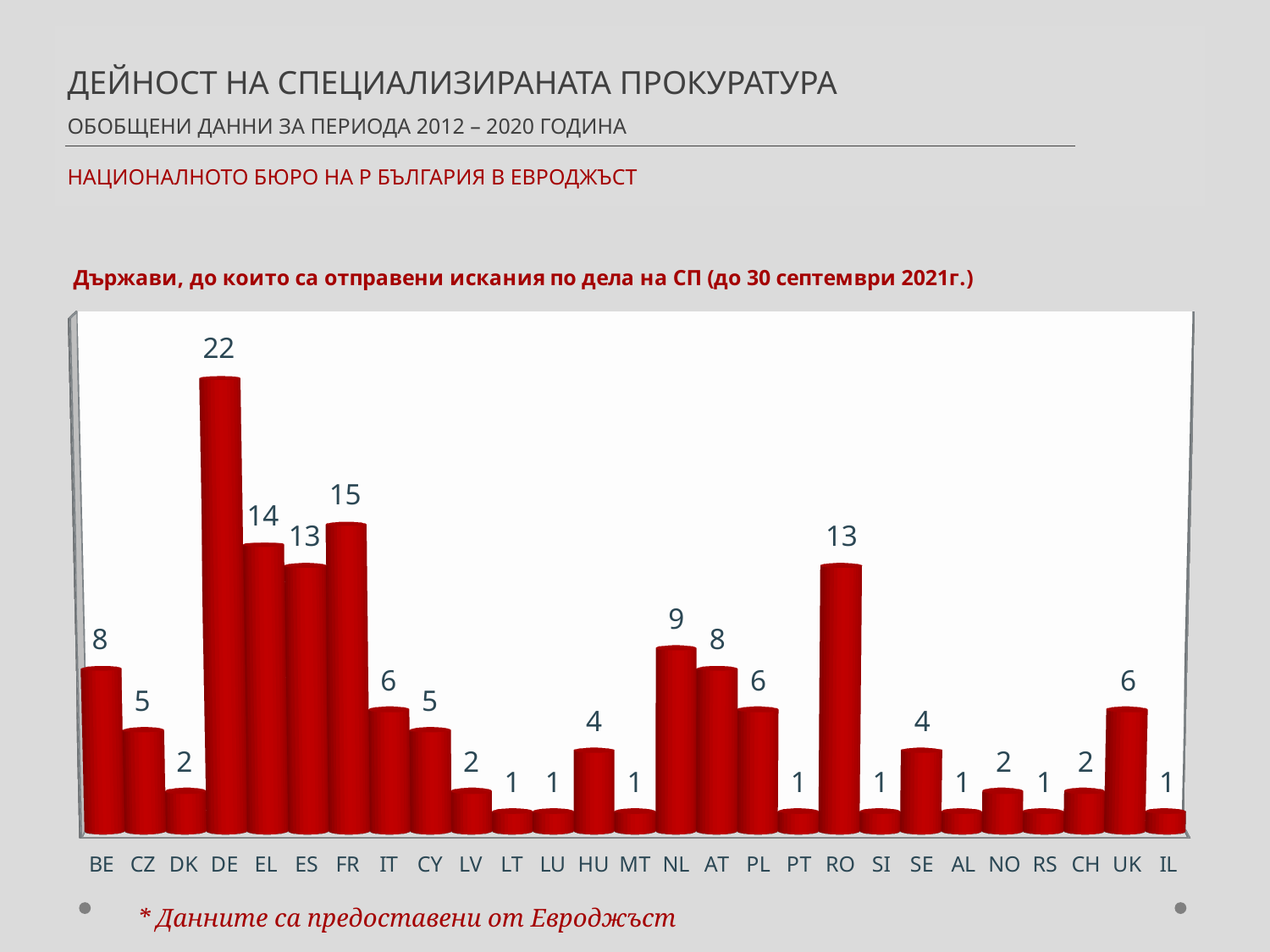
What is the value for NL? 9 What colour are the bars in the chart? red What is the difference between the values for DE and FR? 7 What is the value for DE? 22 What kind of chart is shown on the slide? bar chart Which is larger, the value for HU or the value for PL? PL What is the value for UK? 6 Which country has the highest value? DE What is the difference between the values for EL and ES? 1 How many countries are shown on the x axis? 27 Which is larger, the value for BE or the value for CZ? BE What is the value for RO? 13